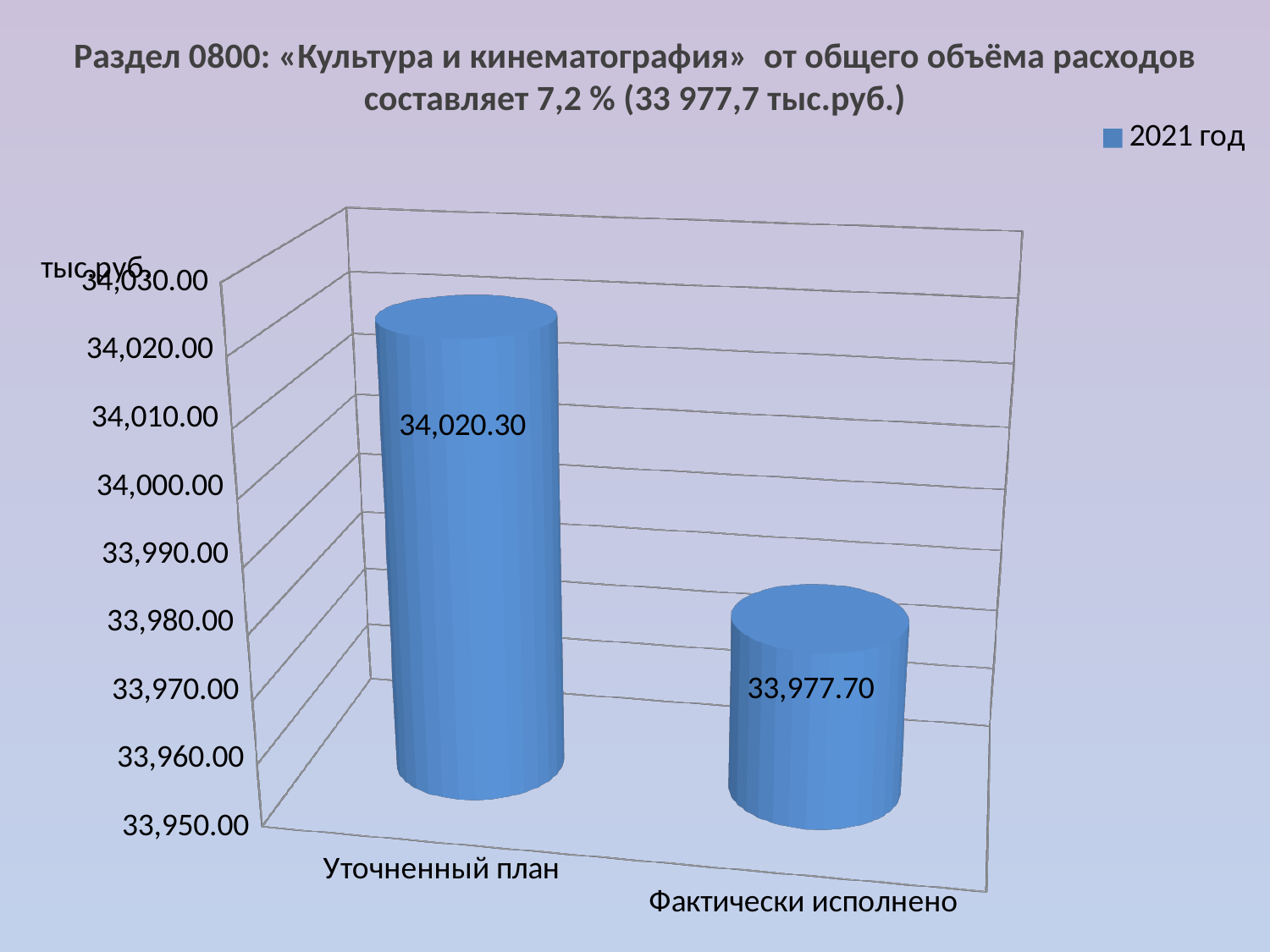
What series name is shown in the legend? 2021 год Is the value for «Фактически исполнено» greater or less than 34,000.00? less How many series does the legend list? 1 What is the difference between the values for «Уточненный план» and «Фактически исполнено»? 42.60 Which category has the lowest value? Фактически исполнено Is the value for «Уточненный план» greater or less than 34,000.00? greater How many categories are shown on the chart? 2 What kind of chart is shown on the slide? bar chart Which category has the highest value? Уточненный план Which is larger: the value for «Уточненный план» or for «Фактически исполнено»? Уточненный план What is the value for «Уточненный план»? 34,020.30 What is the value for «Фактически исполнено»? 33,977.70